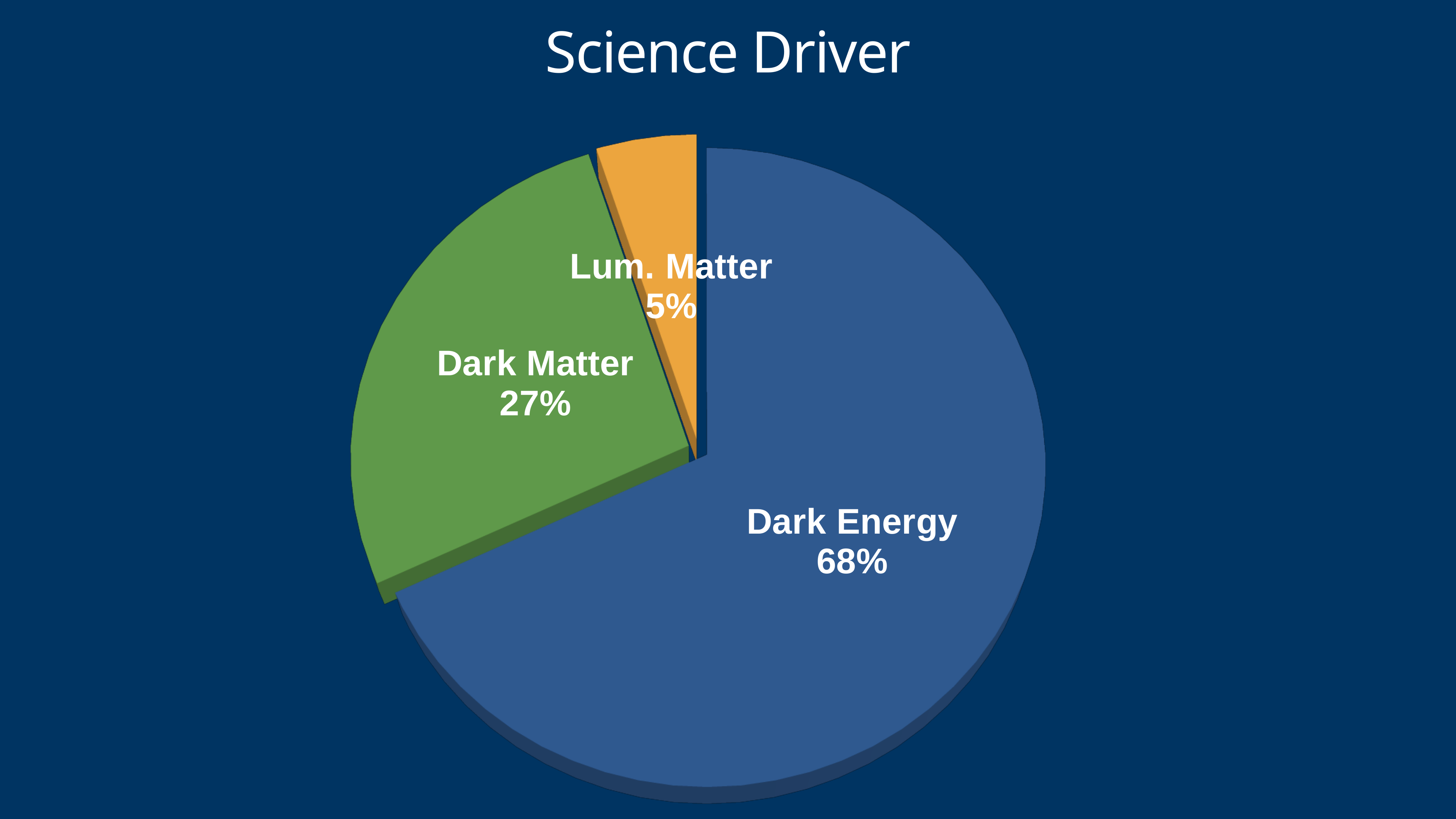
What percentage of the pie is Lum. Matter? 5% What type of chart is shown on the slide? pie chart What percentage of the pie is Dark Energy? 68% How many slices does the pie chart have? 3 Which slice of the pie is the largest? Dark Energy Which slice of the pie is the smallest? Lum. Matter What is the difference in percentage points between Dark Matter and Lum. Matter? 22 What is the title of the slide? Science Driver What is the difference in percentage points between Dark Energy and Dark Matter? 41 What percentage of the pie is Dark Matter? 27% Which is larger, Dark Matter or Lum. Matter? Dark Matter What colour is the Dark Matter slice? green